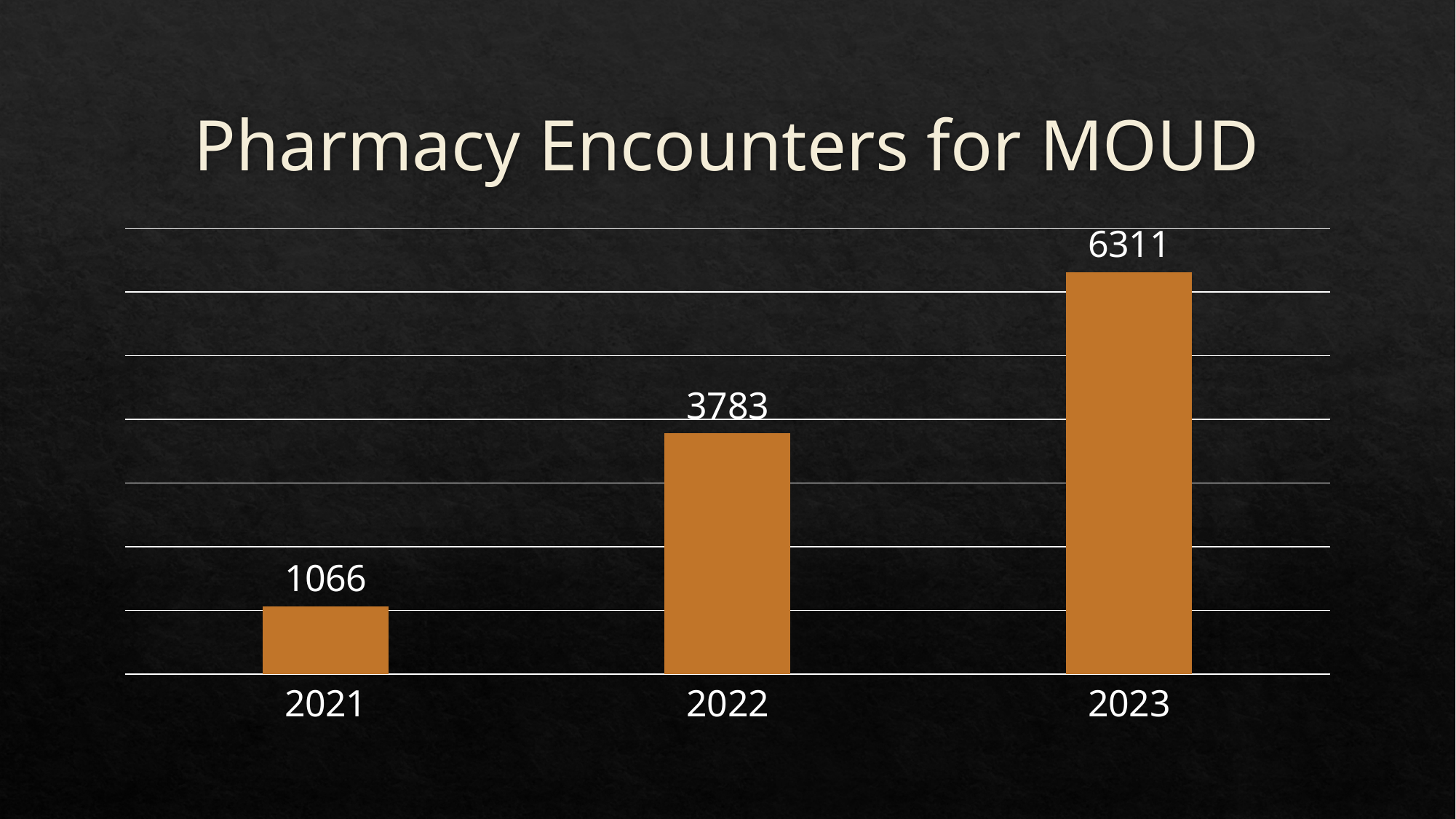
What is the value for 2021? 1066 What is the title of the chart? Pharmacy Encounters for MOUD What kind of chart is shown on the slide? bar chart What is the value for 2022? 3783 Do the values rise or fall from 2021 to 2023? rise Which is larger, the value for 2021 or the value for 2022? 2022 Which year has the highest value? 2023 What is the difference between the values for 2022 and 2021? 2717 What is the value for 2023? 6311 How many years are shown on the chart? 3 What is the difference between the values for 2023 and 2022? 2528 Which year has the lowest value? 2021